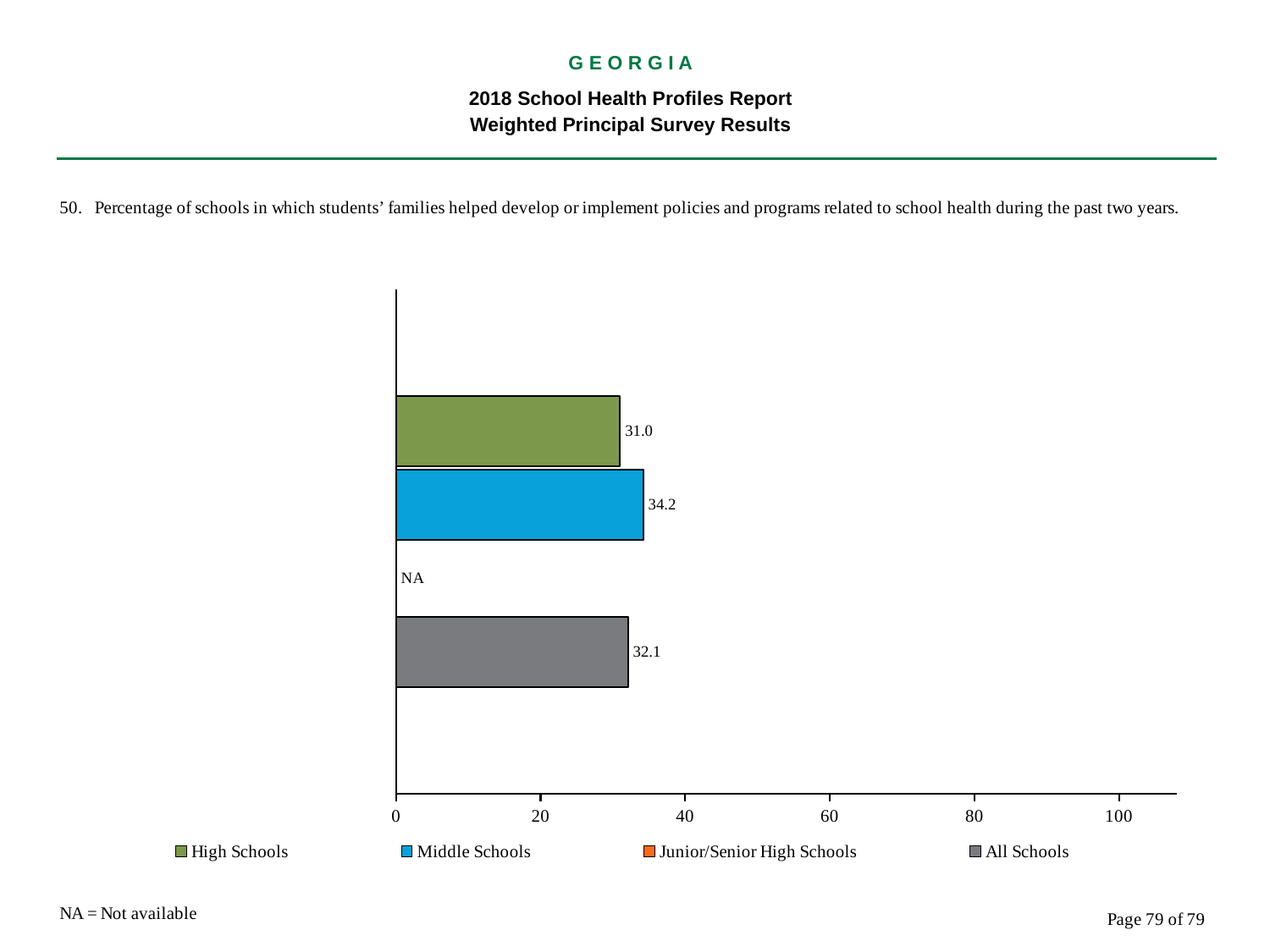
What is the difference between the Middle Schools value and the High Schools value? 3.2 Which school type with a plotted value has the lowest value? High Schools What is shown for Junior/Senior High Schools? NA Which school type has the highest value? Middle Schools Is the value for Middle Schools greater or less than 40? less What is the value for High Schools? 31.0 What is the value for Middle Schools? 34.2 What kind of chart is shown? bar chart Which is larger, the value for All Schools or the value for High Schools? All Schools What is the value for All Schools? 32.1 What does NA stand for according to the note on the slide? Not available How many series does the legend list? 4